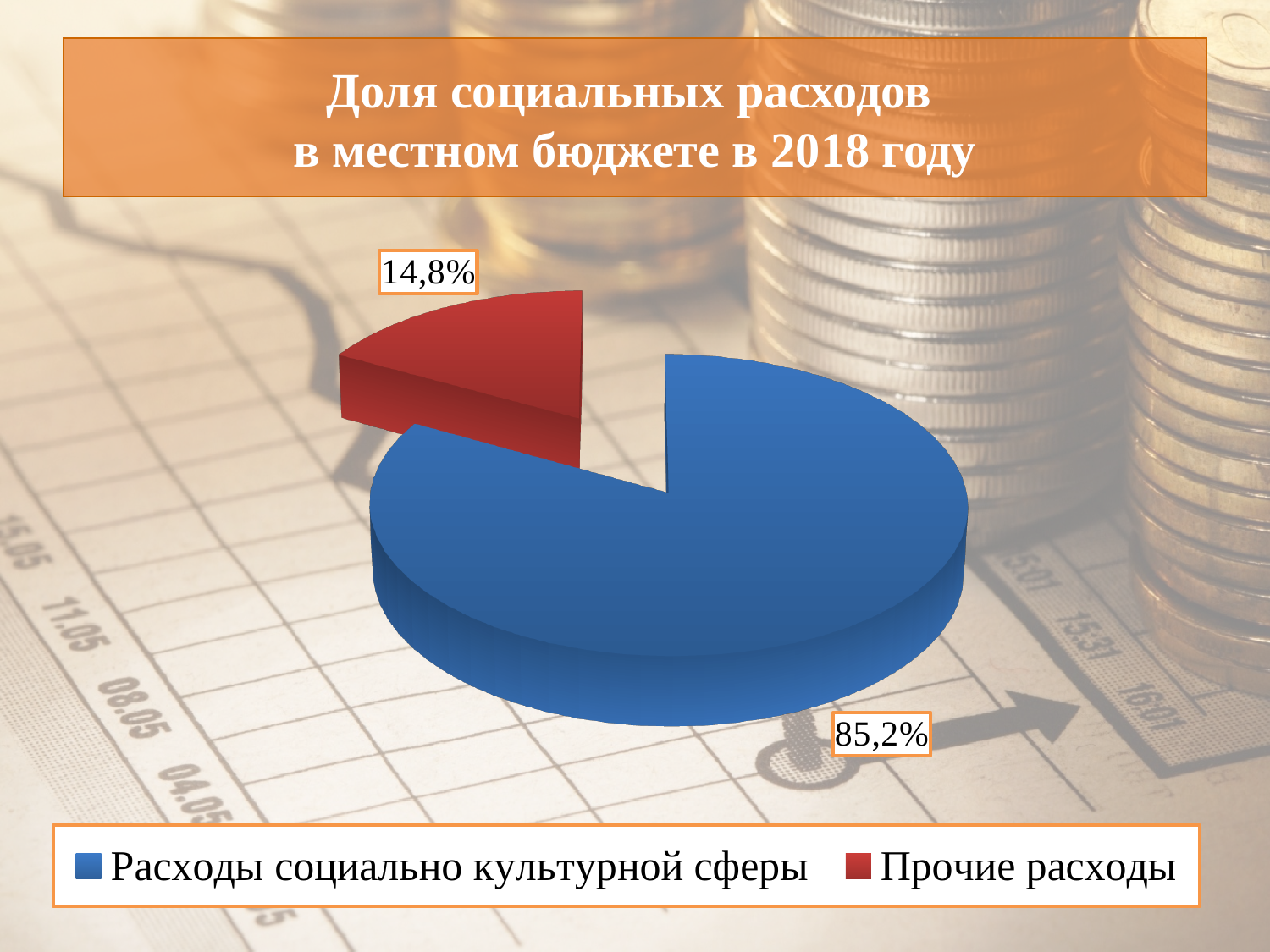
How many entries does the legend list? 2 What is the title of the chart? Доля социальных расходов в местном бюджете в 2018 году What share of the pie does "Прочие расходы" take? 14,8% Which is larger: the share for "Расходы социально культурной сферы" or for "Прочие расходы"? Расходы социально культурной сферы What kind of chart is shown on the slide? Pie chart What share of the pie does "Расходы социально культурной сферы" take? 85,2% What colour is the slice for "Прочие расходы"? Red Which category has the largest slice of the pie? Расходы социально культурной сферы How many slices does the pie chart have? 2 Which category has the smallest slice of the pie? Прочие расходы What is the difference in percentage points between "Расходы социально культурной сферы" and "Прочие расходы"? 70,4